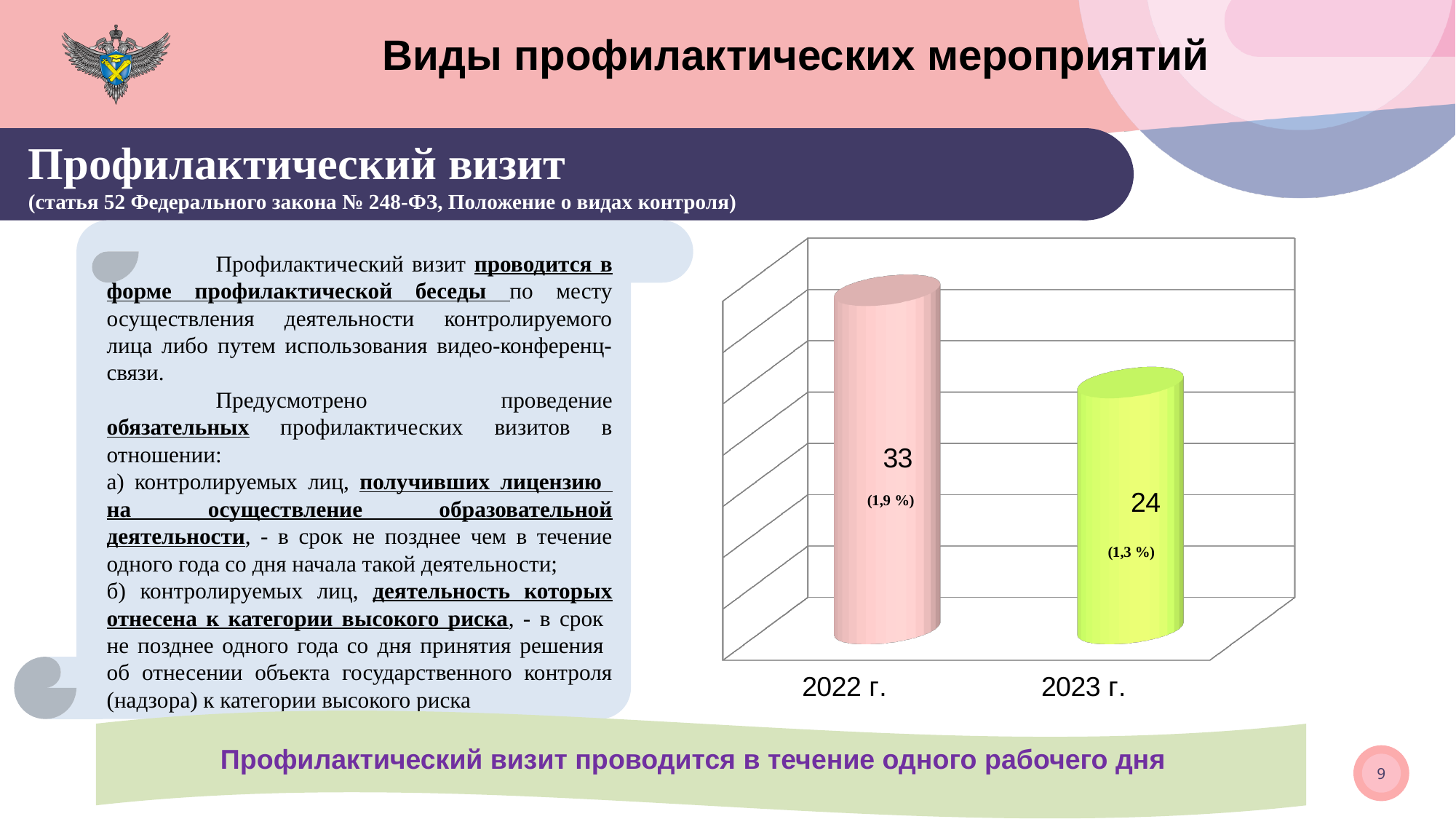
What is the value shown for 2022 г.? 33 Which is larger, the value for 2022 г. or for 2023 г.? 2022 г. What is the value shown for 2023 г.? 24 What colour is the bar for 2023 г.? yellow-green What is the difference between the values for 2022 г. and 2023 г.? 9 What percentage is shown in parentheses for 2022 г.? (1,9 %) What kind of chart is shown on the slide? bar chart How many categories are shown on the chart? 2 Which year has the highest value? 2022 г. Do the values rise or fall from 2022 г. to 2023 г.? fall Which year has the lowest value? 2023 г. What percentage is shown in parentheses for 2023 г.? (1,3 %)